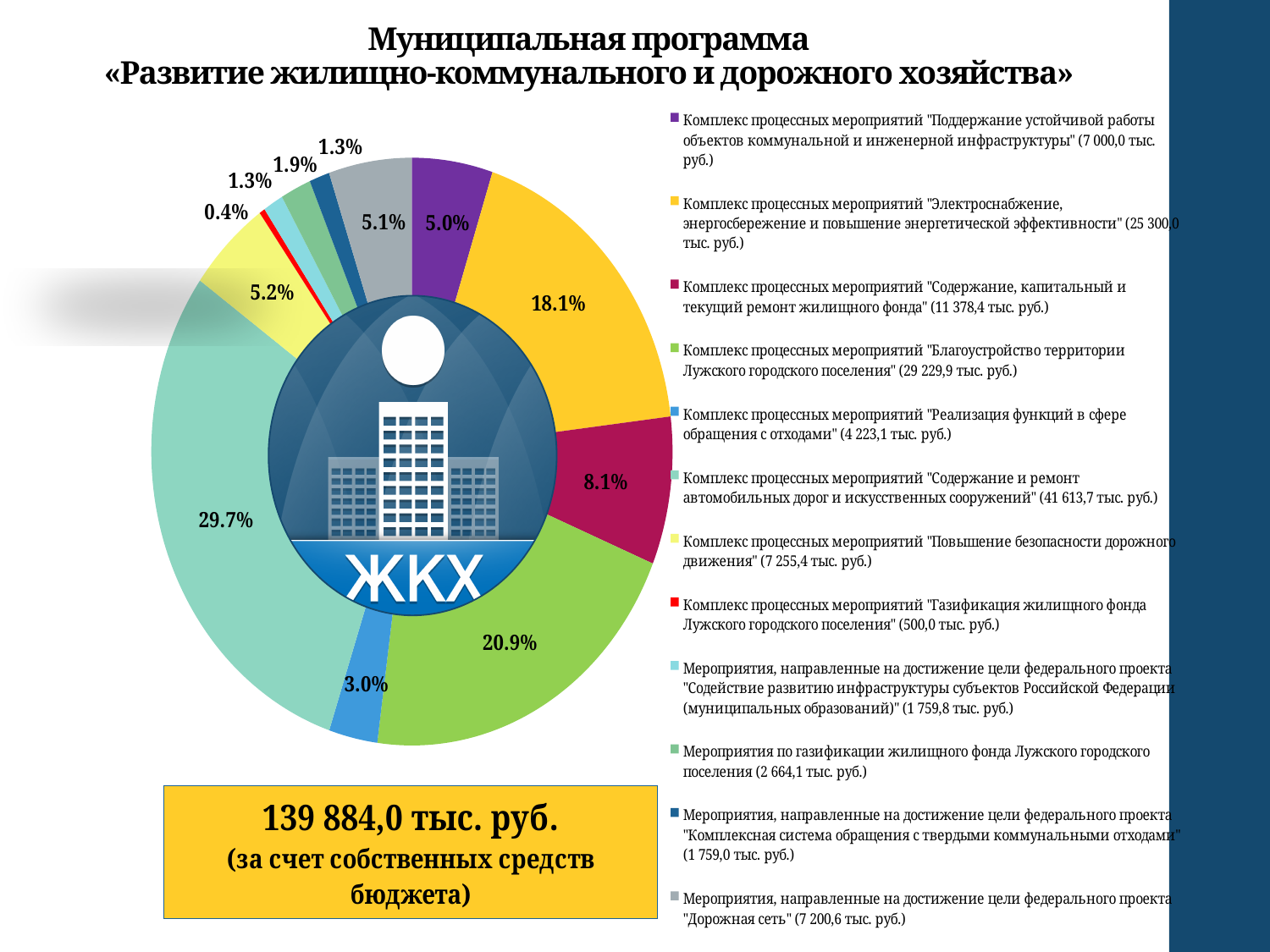
What kind of chart is shown on the slide? Pie chart (doughnut) What percentage is shown for "Реализация функций в сфере обращения с отходами"? 3.0% Which slice of the pie chart is the largest? Содержание и ремонт автомобильных дорог и искусственных сооружений (29.7%) What total amount is shown in the yellow box below the pie chart? 139 884,0 тыс. руб. What amount in thousand rubles is given in the legend for "Содержание и ремонт автомобильных дорог и искусственных сооружений"? 41 613,7 тыс. руб. What share of the pie does "Благоустройство территории Лужского городского поселения" have? 20.9% What is the difference in percentage points between the "Благоустройство территории" slice (20.9%) and the "Электроснабжение" slice (18.1%)? 2.8 percentage points Which is larger: the share for "Повышение безопасности дорожного движения" or the share for "Дорожная сеть"? Повышение безопасности дорожного движения (5.2%) What percentage is shown for "Содержание, капитальный и текущий ремонт жилищного фонда"? 8.1% What share of the pie does "Электроснабжение, энергосбережение и повышение энергетической эффективности" have? 18.1% Which slice of the pie chart is the smallest? Газификация жилищного фонда Лужского городского поселения (0.4%) How many entries does the legend of the pie chart list? 12